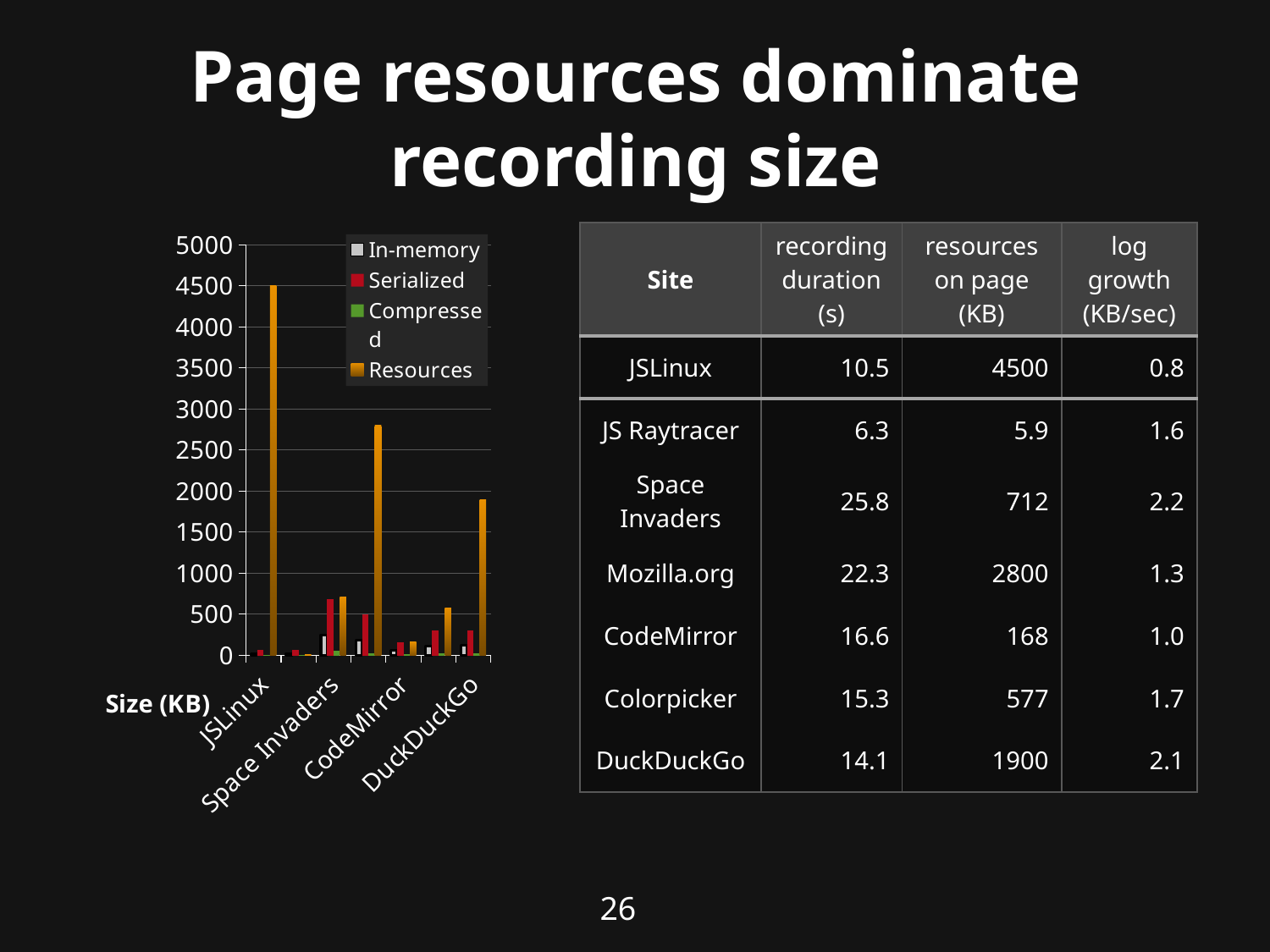
What kind of chart is shown on the slide? bar chart Is the Resources value for Space Invaders greater or less than 1000? less Which category has the highest Resources bar in the chart? JSLinux Is the Resources value for DuckDuckGo greater or less than 1500? greater Which colour represents the Resources series in the chart's legend? orange Is the Resources value for JSLinux greater or less than 4000? greater What is the Resources value for JSLinux in the chart? 4500 How many category groups of bars are plotted in the chart? 7 How many series does the chart's legend list? 4 What is the axis title shown on the chart's vertical axis? Size (KB) Which is larger in the chart: the Resources value for Space Invaders or the Resources value for CodeMirror? Space Invaders